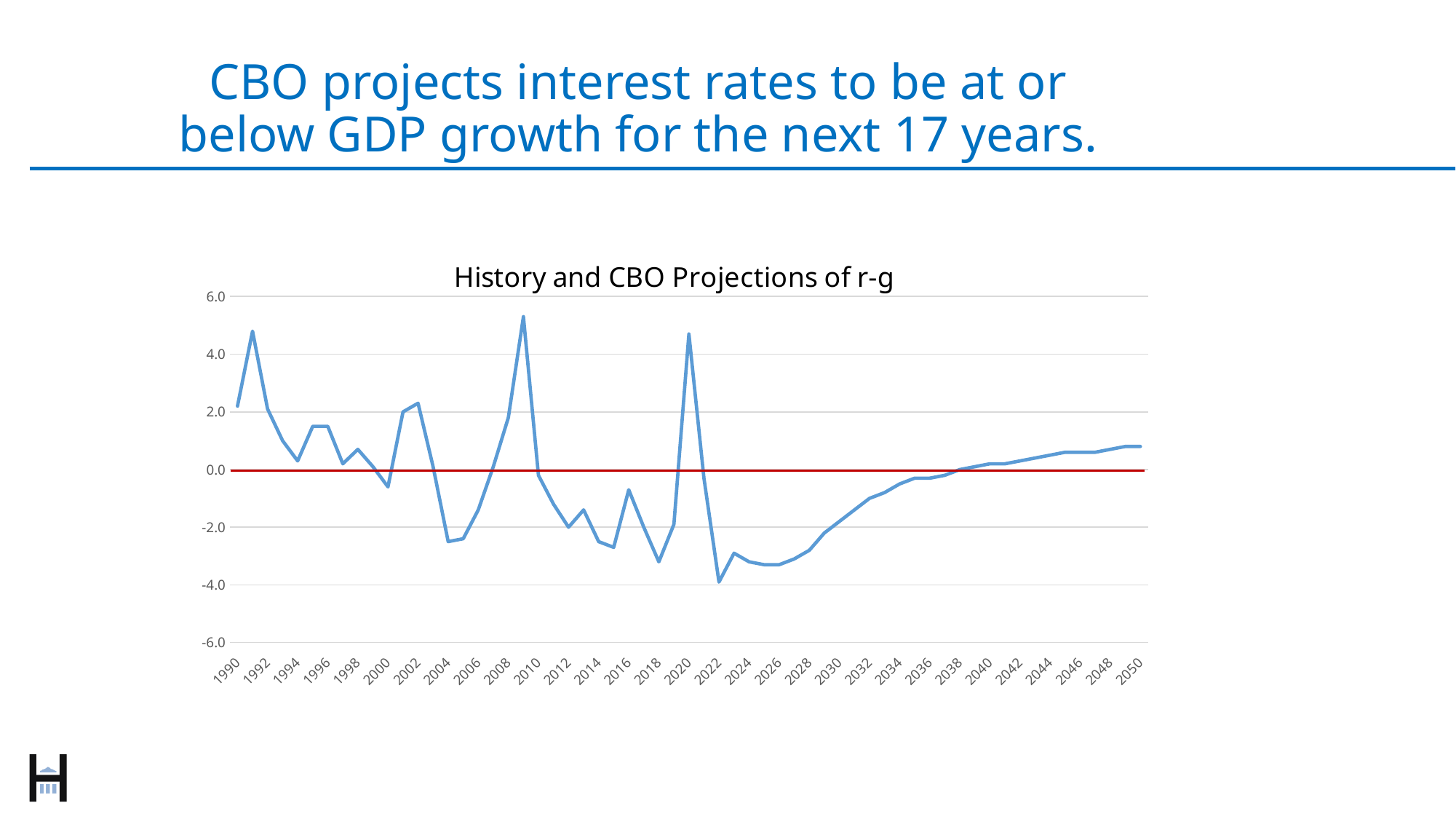
What is the title of the chart? History and CBO Projections of r-g Which year has the higher value, 2009 or 2020? 2009 Is the value for 2050 greater or less than 0.0? greater Is the value for 2022 greater or less than -2.0? less Is the value for 2009 greater or less than 4.0? greater What kind of chart is shown on the slide? line chart In which year does the line reach its highest value? 2009 In which year does the line reach its lowest value? 2022 Do the values generally rise or fall from 2022 to 2050? rise How many year labels are shown on the x axis? 31